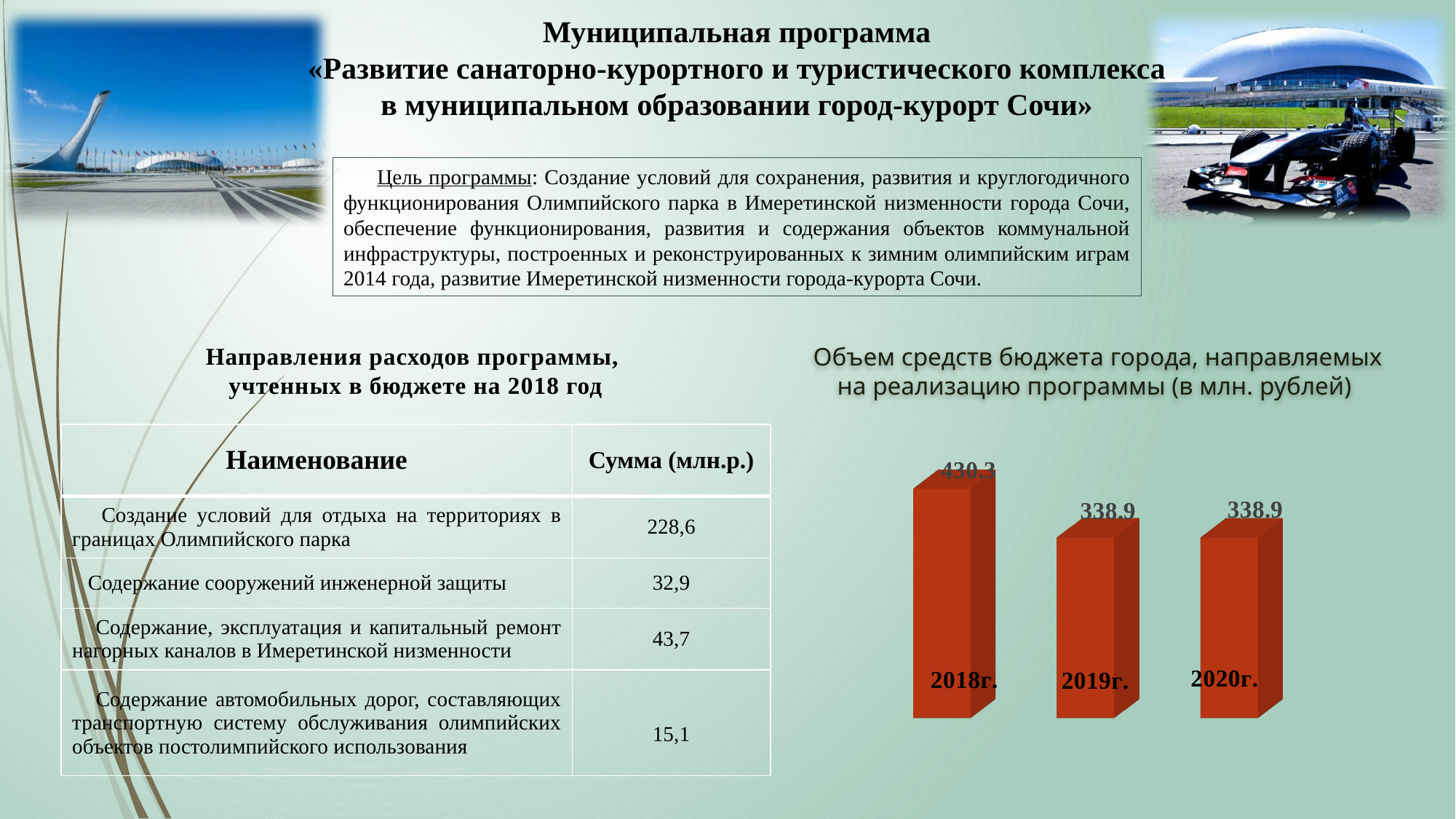
What colour are the bars in the chart? Red How many bars are shown in the chart? 3 Do the values in the chart rise or fall from 2018г. to 2019г.? Fall What kind of chart is shown on the slide? Bar chart What is the difference between the values for 2018г. and 2019г.? 91.4 In what units are the chart values expressed, according to its title? млн. рублей What is the value for 2019г. in the chart 'Объем средств бюджета города, направляемых на реализацию программы'? 338.9 What is the value for 2018г. in the chart? 430.3 What is the value for 2020г. in the chart? 338.9 Which is larger, the value for 2018г. or the value for 2020г.? 2018г. Are the values for 2019г. and 2020г. equal? Yes Which year has the highest value in the chart? 2018г.